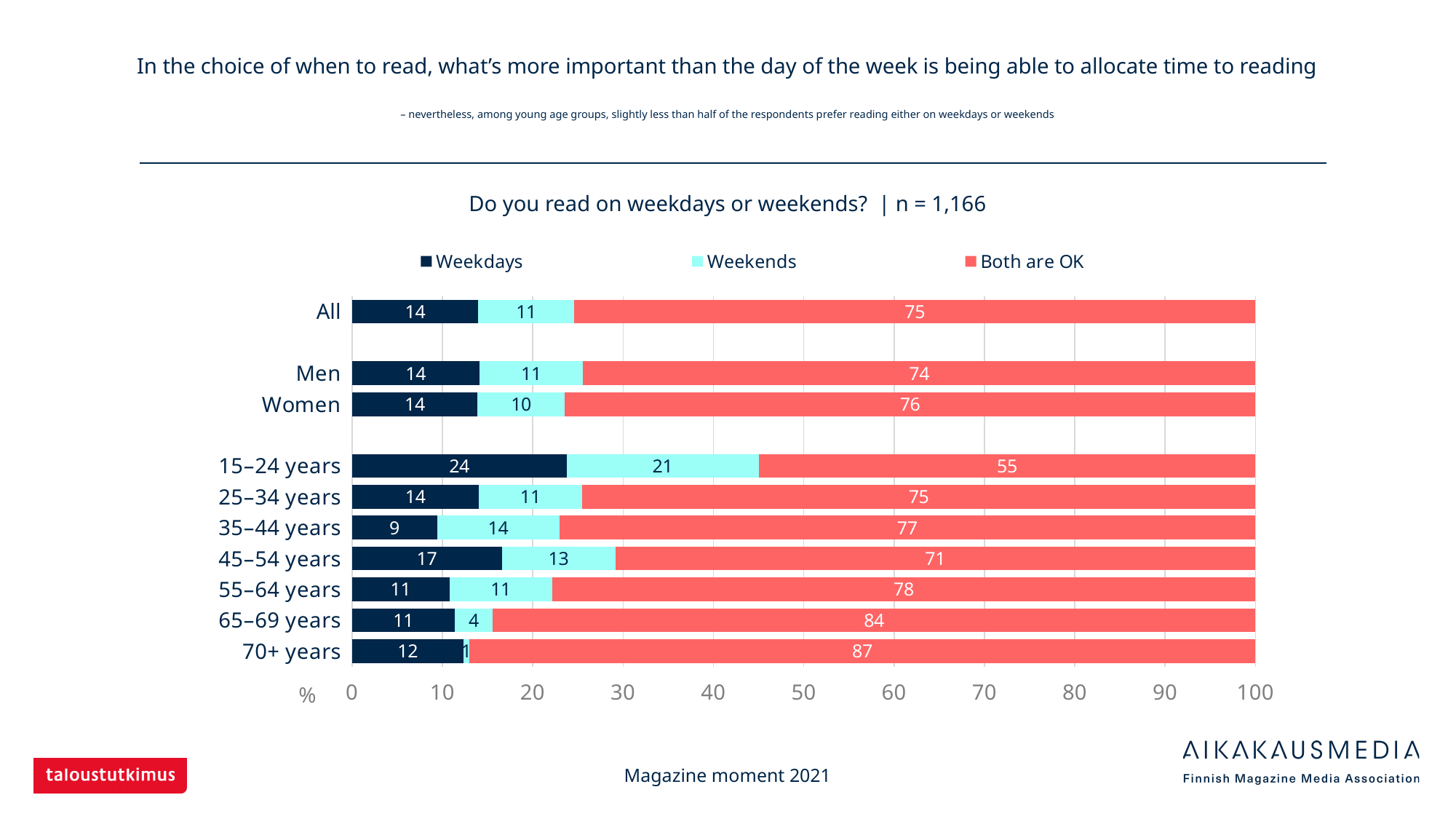
Which age group has the highest "Both are OK" value? 70+ years What is the total of the stacked bar for the 45–54 years group? 101 Which is larger, the "Weekends" value for 35–44 years or for 45–54 years? 35–44 years What percentage of respondents aged 15–24 years answered "Weekdays"? 24 What is the "Both are OK" value for the 70+ years group? 87 What is the difference between the "Both are OK" values for 70+ years and 15–24 years? 32 What kind of chart is shown on the slide? Stacked bar chart Which age group has the lowest "Weekdays" value? 35–44 years What is the sample size (n) stated in the chart title? 1,166 How many categories are shown on the vertical axis? 10 How many series does the legend list? 3 What is the "Weekends" value for Women? 10